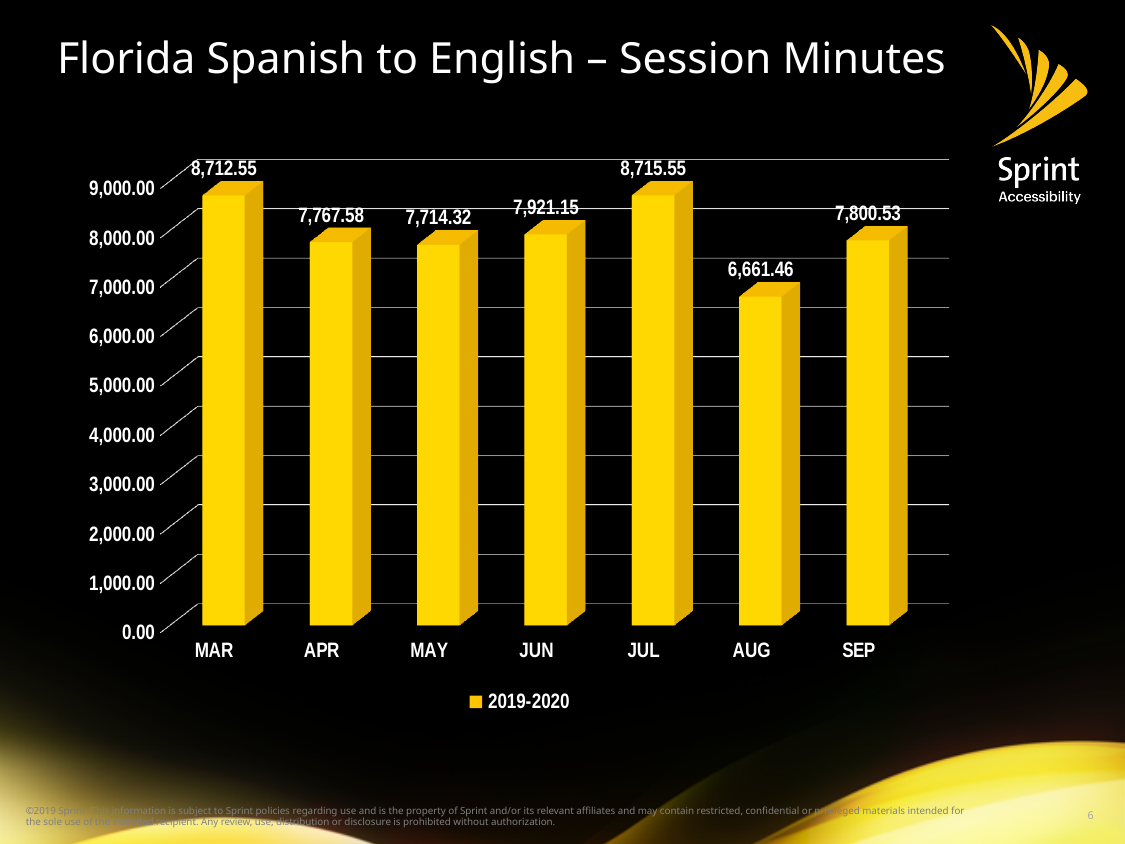
What kind of chart is shown on the slide? bar chart Is the value for AUG greater or less than 7,000.00? less What is the difference between the values for JUN and MAY? 206.83 Which month has the lowest session minutes? AUG What is the difference between the values for JUL and AUG? 2,054.09 How many months are shown on the x axis? 7 How many series does the legend list? 1 What is the value for SEP? 7,800.53 What is the legend entry for the series shown? 2019-2020 What is the value for MAR? 8,712.55 Which is larger, the value for JUN or the value for MAY? JUN What is the value for AUG? 6,661.46